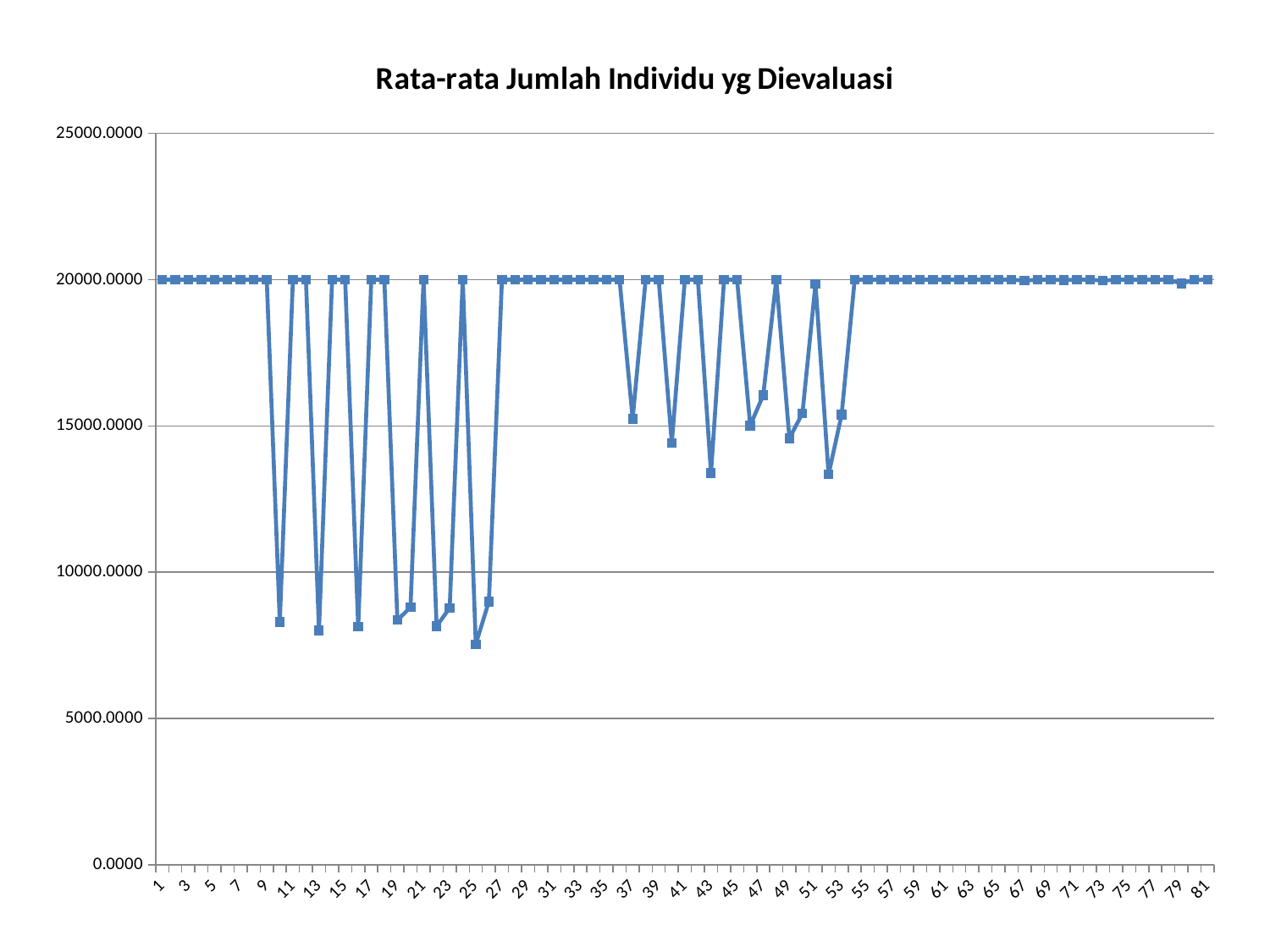
What is the title of the chart? Rata-rata Jumlah Individu yg Dievaluasi Is the value at x = 43 greater or less than 15000? less What is the value at x = 1? 20000.0000 What is the highest label shown on the y axis? 25000.0000 Is the value at x = 47 greater or less than 15000? greater What is the highest value reached by the line? 20000.0000 Is the value at x = 10 greater or less than 10000? less At which x value does the line reach its lowest point? 25 Which is larger, the value at x = 13 or the value at x = 41? x = 41 What kind of chart is shown on the slide? line chart Which is larger, the value at x = 52 or the value at x = 55? x = 55